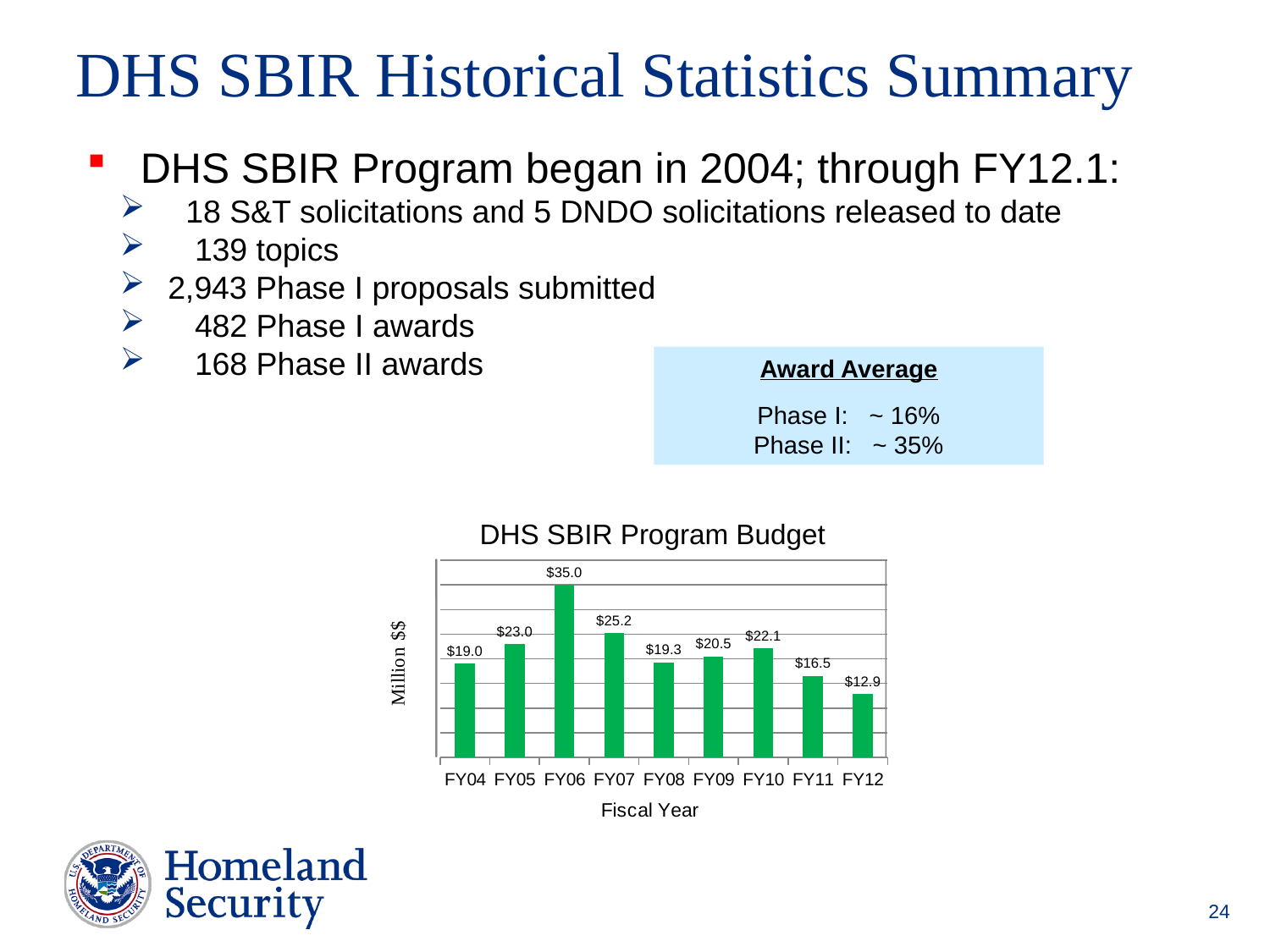
What is the DHS SBIR Program Budget for FY12? $12.9 What is the difference between the FY06 and FY07 DHS SBIR Program Budget values? $9.8 Which fiscal year has the lowest DHS SBIR Program Budget? FY12 What is the DHS SBIR Program Budget for FY06? $35.0 What is the label of the y axis in the DHS SBIR Program Budget chart? Million $$ Which fiscal year has the highest DHS SBIR Program Budget? FY06 Which fiscal year has a larger DHS SBIR Program Budget, FY10 or FY11? FY10 What kind of chart is the DHS SBIR Program Budget chart? bar chart What is the difference between the FY05 and FY04 DHS SBIR Program Budget values? $4.0 How many fiscal years are shown in the DHS SBIR Program Budget chart? 9 What is the DHS SBIR Program Budget for FY09? $20.5 Does the DHS SBIR Program Budget rise or fall from FY10 to FY12? fall